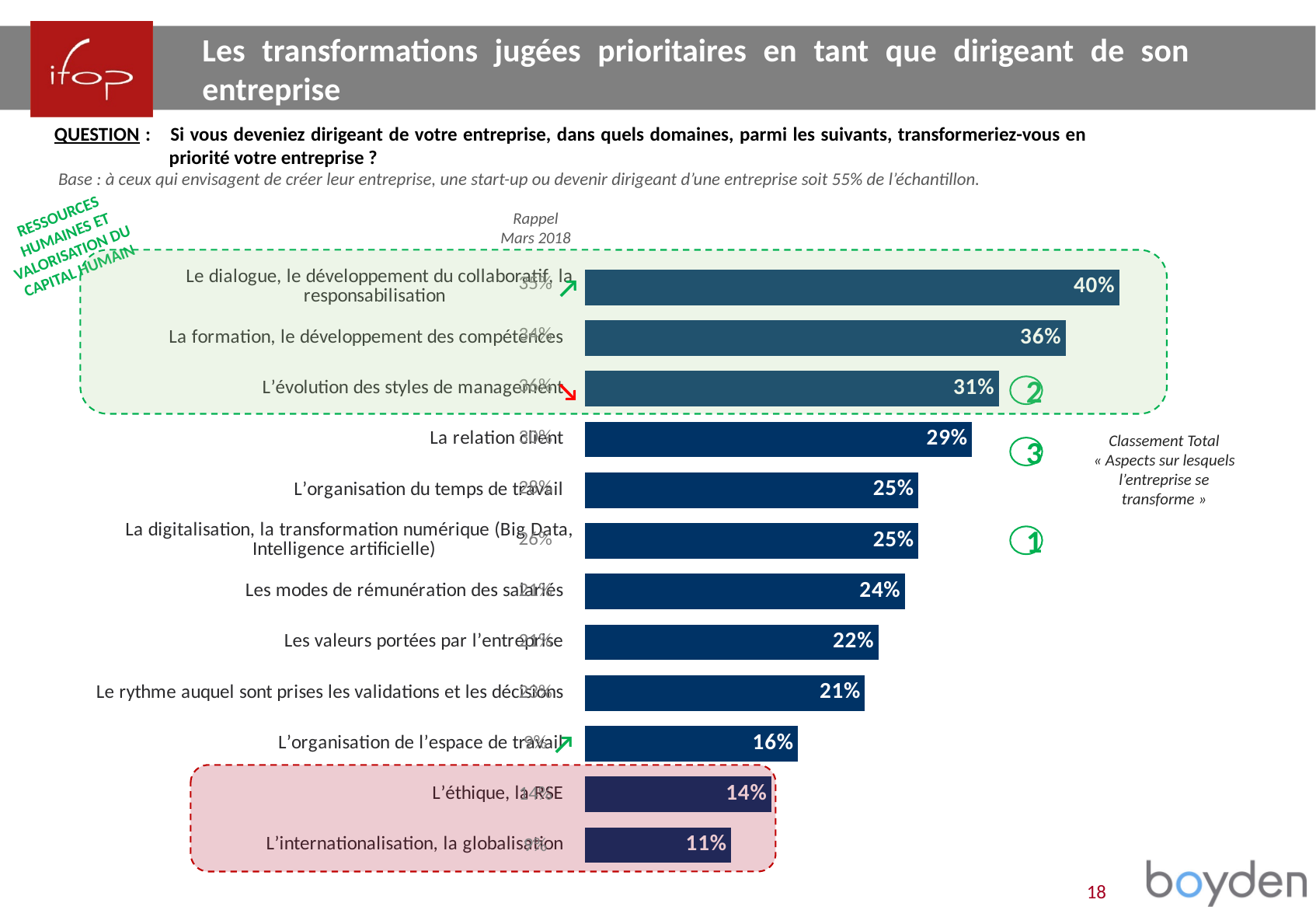
Which category has the lowest value? L'internationalisation, la globalisation What is the value for "Les modes de rémunération des salariés"? 24% What is the difference between the values for "Le dialogue, le développement du collaboratif, la responsabilisation" and "L'évolution des styles de management"? 9% How many categories (transformation domains) are plotted in the chart? 12 What kind of chart is shown on the slide? bar chart What is the value for "L'éthique, la RSE"? 14% What is the value for "La relation client"? 29% Which is larger: the value for "Les valeurs portées par l'entreprise" or the value for "L'organisation de l'espace de travail"? Les valeurs portées par l'entreprise Do the bar values rise or fall from the top of the chart to the bottom? fall Which category has the highest value? Le dialogue, le développement du collaboratif, la responsabilisation What is the difference between the values for "L'éthique, la RSE" and "L'internationalisation, la globalisation"? 3% What is the value for "La formation, le développement des compétences"? 36%